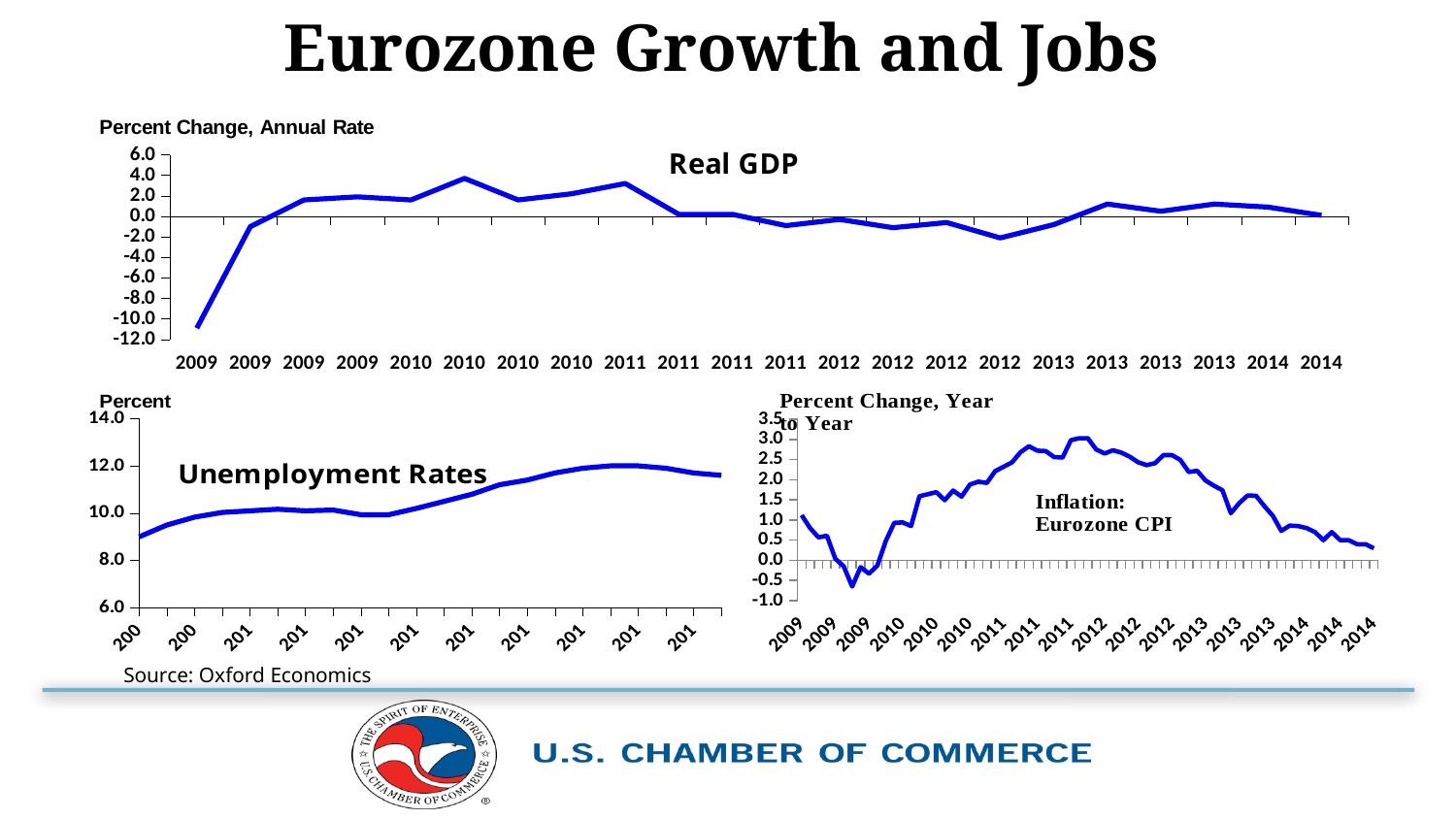
In the Inflation: Eurozone CPI chart, do the values rise or fall from 2012 to 2014? fall In the Real GDP chart, is the highest 2010 value greater or less than 2.0? greater In the Inflation: Eurozone CPI chart, is the lowest 2009 value greater or less than 0.0? less In the Inflation: Eurozone CPI chart, is the peak value in 2012 greater or less than 2.5? greater In the Real GDP chart, in which year does the line reach its lowest value? 2009 What is the y-axis label of the Real GDP chart? Percent Change, Annual Rate What kind of chart is the Real GDP chart? line chart In the Unemployment Rates chart, do the values overall rise or fall from the first point to the last point? rise How many charts are shown on the slide? 3